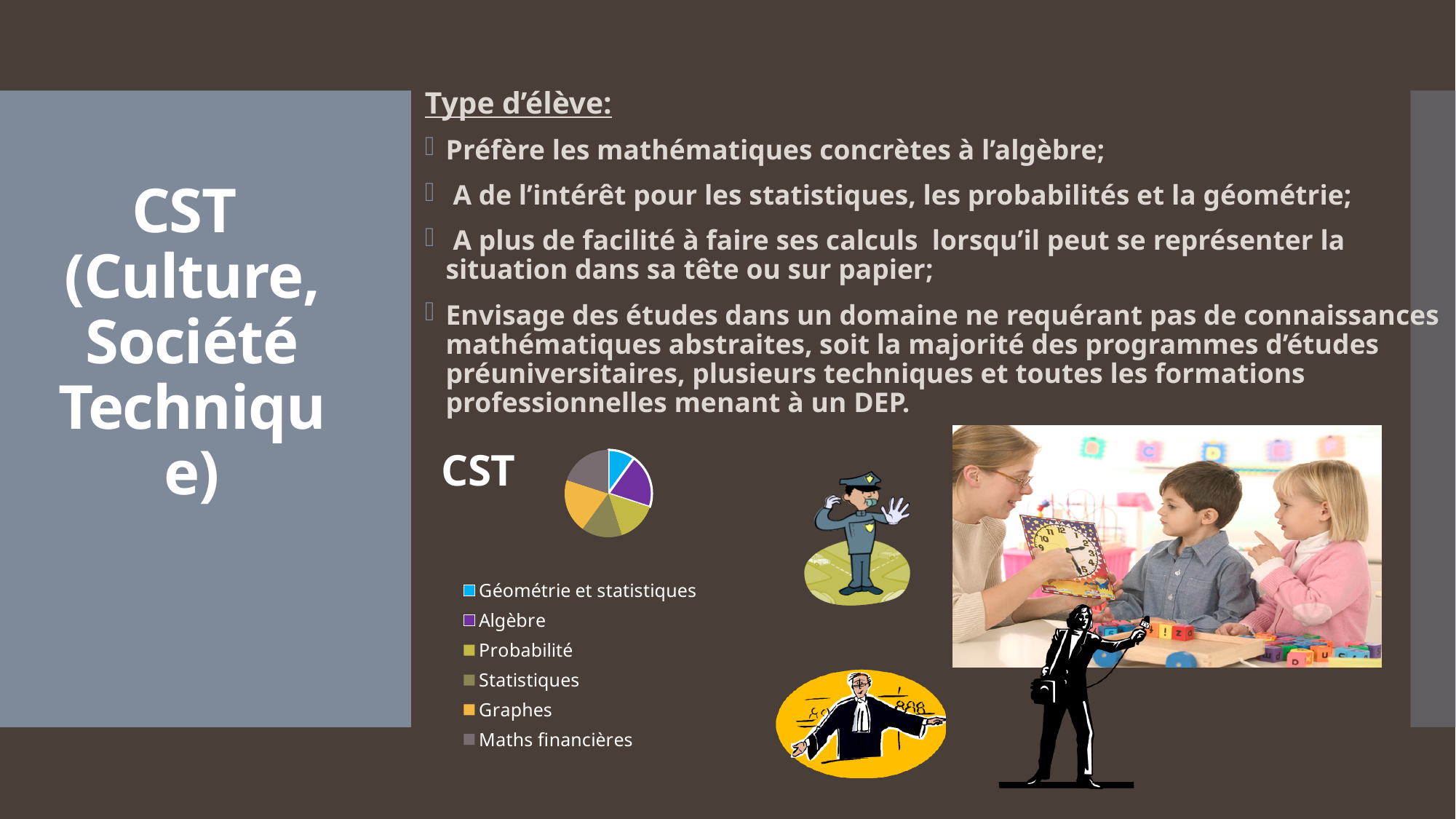
What is the title of the pie chart? CST Which category is listed first in the legend of the pie chart? Géométrie et statistiques Which category is listed last in the legend of the pie chart? Maths financières How many categories does the legend of the pie chart list? 6 Which slice is larger in the pie chart, Maths financières or Géométrie et statistiques? Maths financières What kind of chart is shown on the slide? pie chart Which category has the smallest slice in the pie chart? Géométrie et statistiques Which slice is larger in the pie chart, Algèbre or Géométrie et statistiques? Algèbre